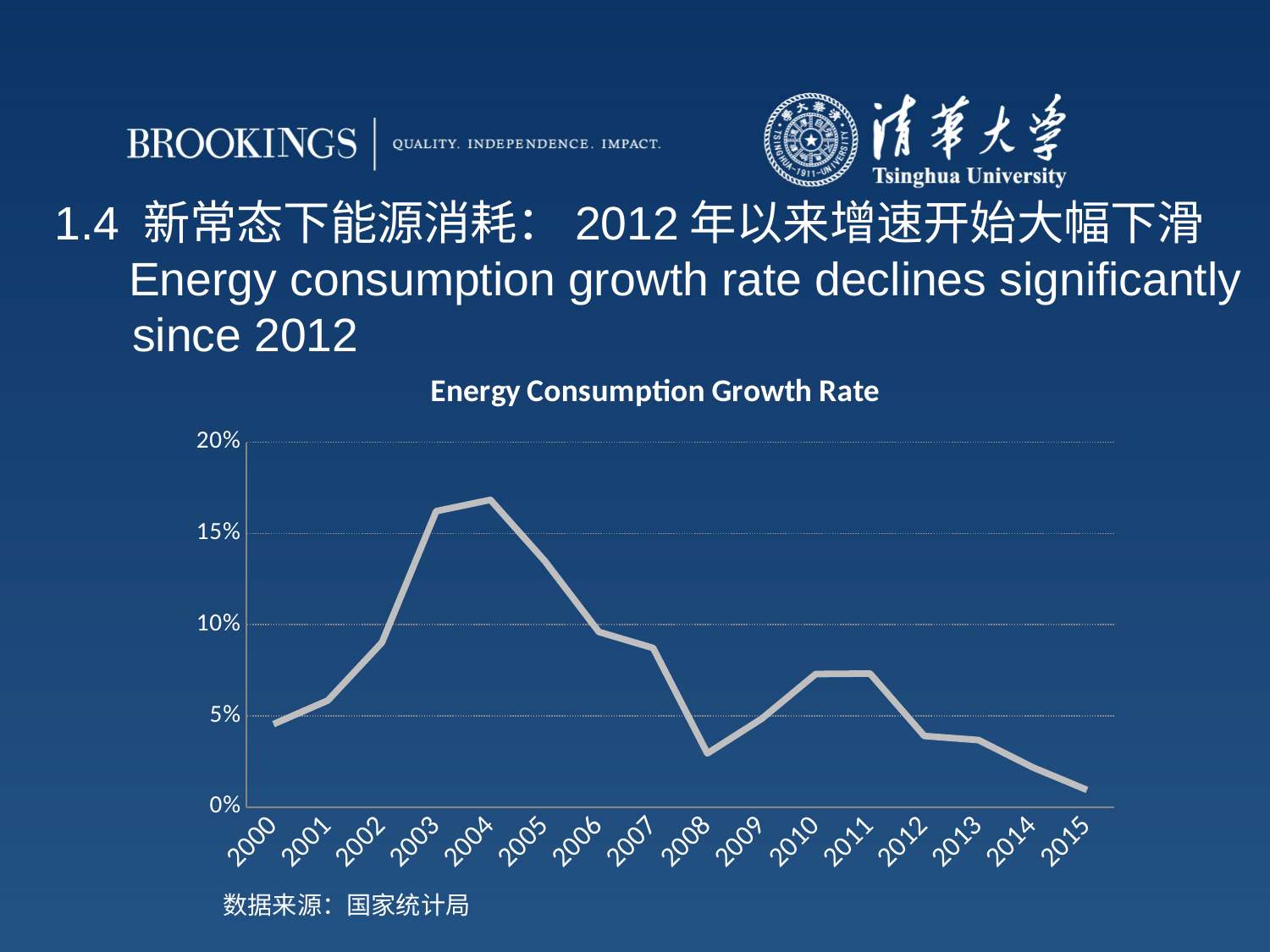
Which year has a higher energy consumption growth rate, 2010 or 2012? 2010 Is the value for 2003 greater or less than 15%? greater Is the value for 2005 greater or less than 10%? greater What is the title of the chart? Energy Consumption Growth Rate Which year has a higher energy consumption growth rate, 2004 or 2008? 2004 Is the value for 2008 greater or less than 5%? less How many years are plotted on the x axis of the chart? 16 In which year is the energy consumption growth rate lowest? 2015 In which year is the energy consumption growth rate highest? 2004 Does the energy consumption growth rate rise or fall from 2011 to 2015? fall What type of chart is shown on the slide? line chart